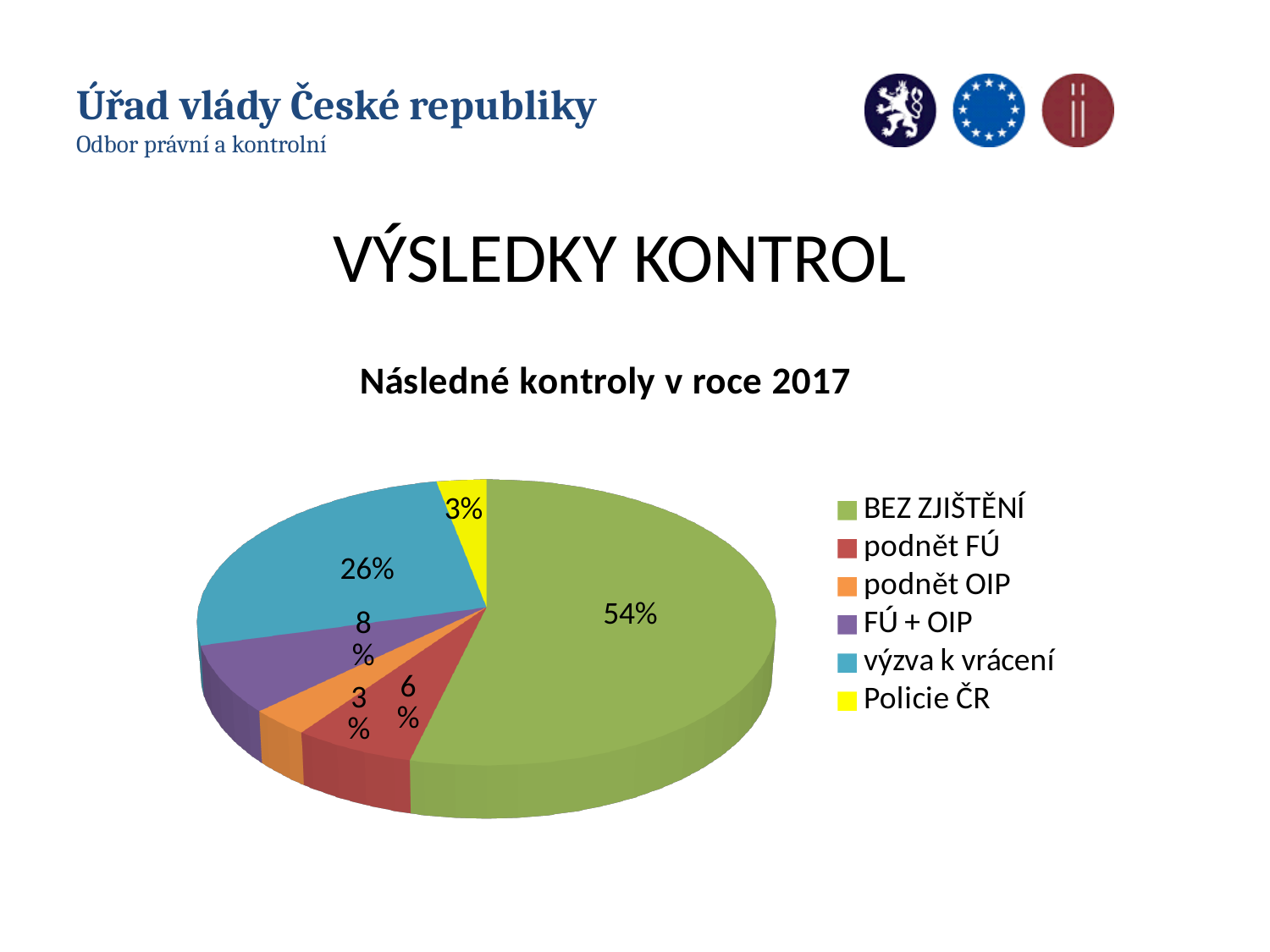
What share of the pie does FÚ + OIP represent? 8% How many categories does the legend list? 6 What share of the pie does BEZ ZJIŠTĚNÍ represent? 54% What share of the pie does výzva k vrácení represent? 26% Which is larger, the share for podnět FÚ or the share for FÚ + OIP? FÚ + OIP Which category has the largest slice of the pie? BEZ ZJIŠTĚNÍ What is the difference between the shares of BEZ ZJIŠTĚNÍ and výzva k vrácení? 28% What share of the pie does podnět FÚ represent? 6% What share of the pie does Policie ČR represent? 3% What kind of chart is shown on the slide? Pie chart What is the title of the chart? Následné kontroly v roce 2017 What colour is the slice for Policie ČR? Yellow